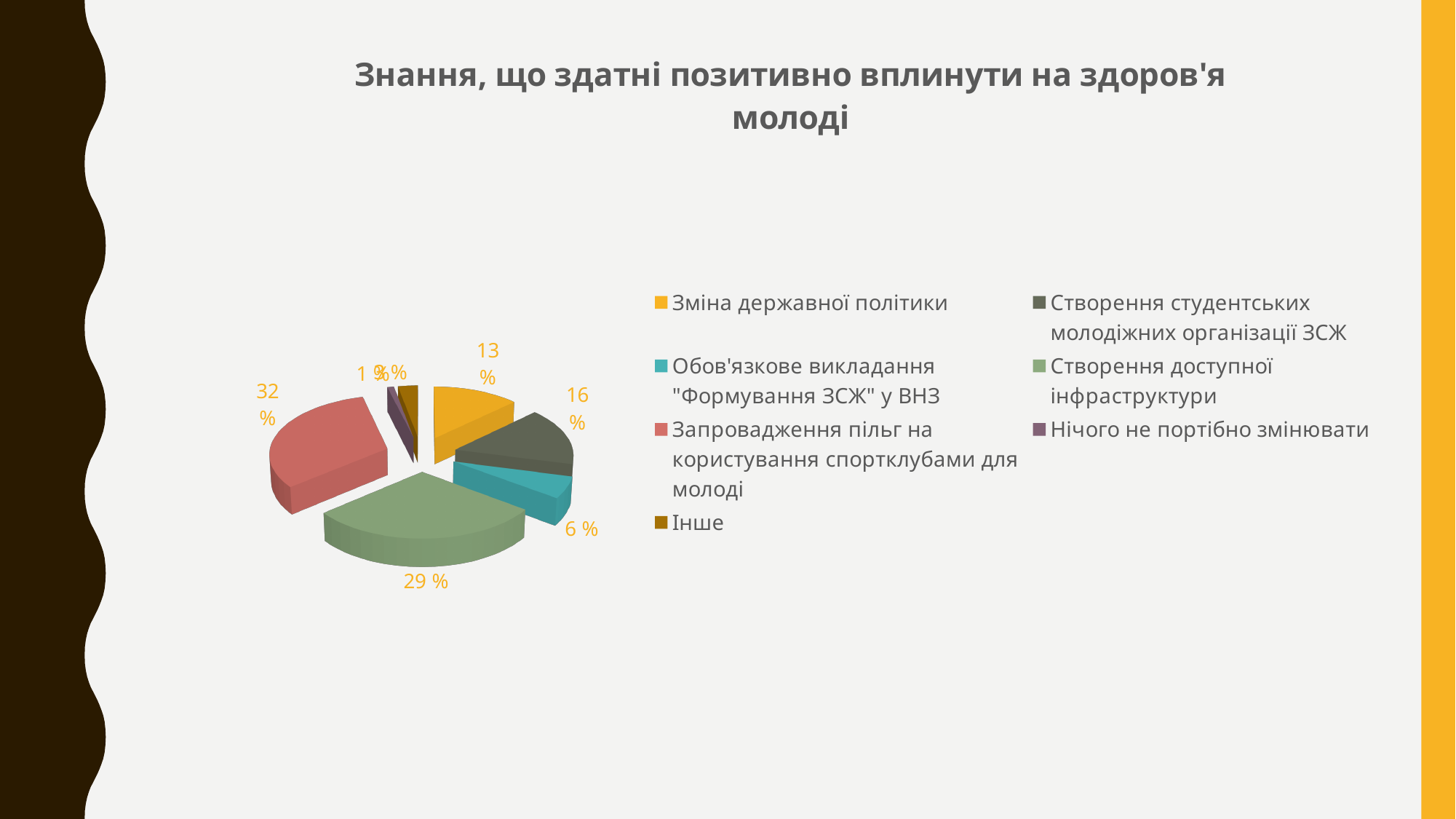
What share does "Зміна державної політики" have? 13 % What share does "Обов'язкове викладання "Формування ЗСЖ" у ВНЗ" have? 6 % Which category has the largest share of the pie? Запровадження пільг на користування спортклубами для молоді What share does "Створення студентських молодіжних організації ЗСЖ" have? 16 % What share does "Створення доступної інфраструктури" have? 29 % What is the difference in percentage points between "Запровадження пільг на користування спортклубами для молоді" and "Створення доступної інфраструктури"? 3 How many categories does the legend list? 7 What share does "Запровадження пільг на користування спортклубами для молоді" have? 32 % What colour is the slice for "Створення доступної інфраструктури"? green Which is larger: the share for "Створення студентських молодіжних організації ЗСЖ" or for "Обов'язкове викладання "Формування ЗСЖ" у ВНЗ"? Створення студентських молодіжних організації ЗСЖ What is the title of the chart? Знання, що здатні позитивно вплинути на здоров'я молоді What kind of chart is shown on the slide? pie chart